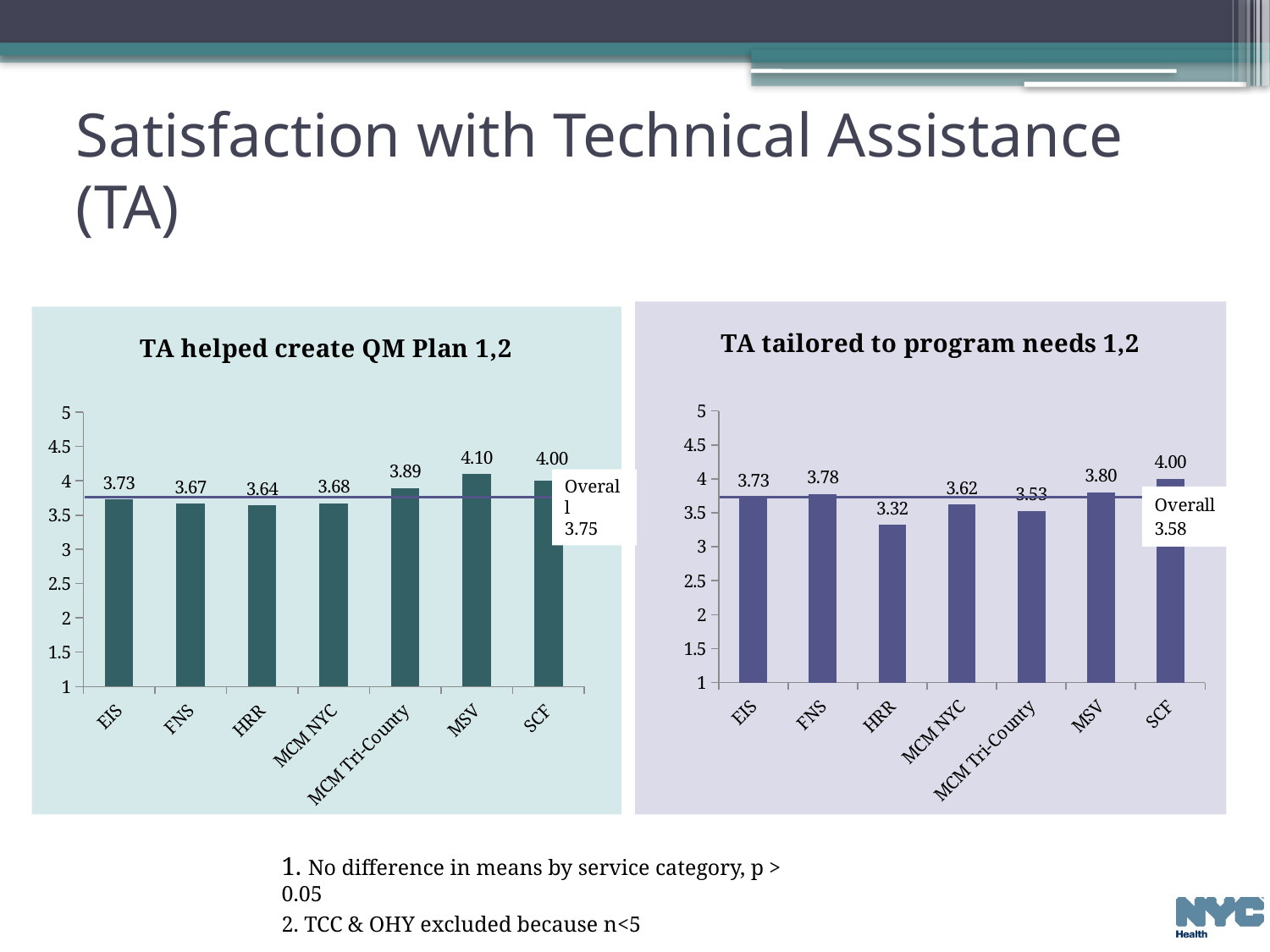
In the 'TA helped create QM Plan' chart, which category has the lowest value? HRR In the 'TA helped create QM Plan' chart, what is the overall value shown by the horizontal line? 3.75 How many categories are shown on the x axis of the 'TA helped create QM Plan' chart? 7 In the 'TA tailored to program needs' chart, which category has the highest value? SCF What kind of chart is the 'TA tailored to program needs' chart? Bar chart In the 'TA tailored to program needs' chart, what is the difference between the values for SCF and MCM NYC? 0.38 In the 'TA tailored to program needs' chart, what is the overall value shown by the horizontal line? 3.58 In the 'TA helped create QM Plan' chart, what is the difference between the values for MSV and HRR? 0.46 In the 'TA tailored to program needs' chart, which is larger, the value for FNS or the value for MCM Tri-County? FNS In the 'TA tailored to program needs' chart, which category has the lowest value? HRR In the 'TA helped create QM Plan' chart, what is the value for MSV? 4.10 In the 'TA tailored to program needs' chart, what is the value for HRR? 3.32